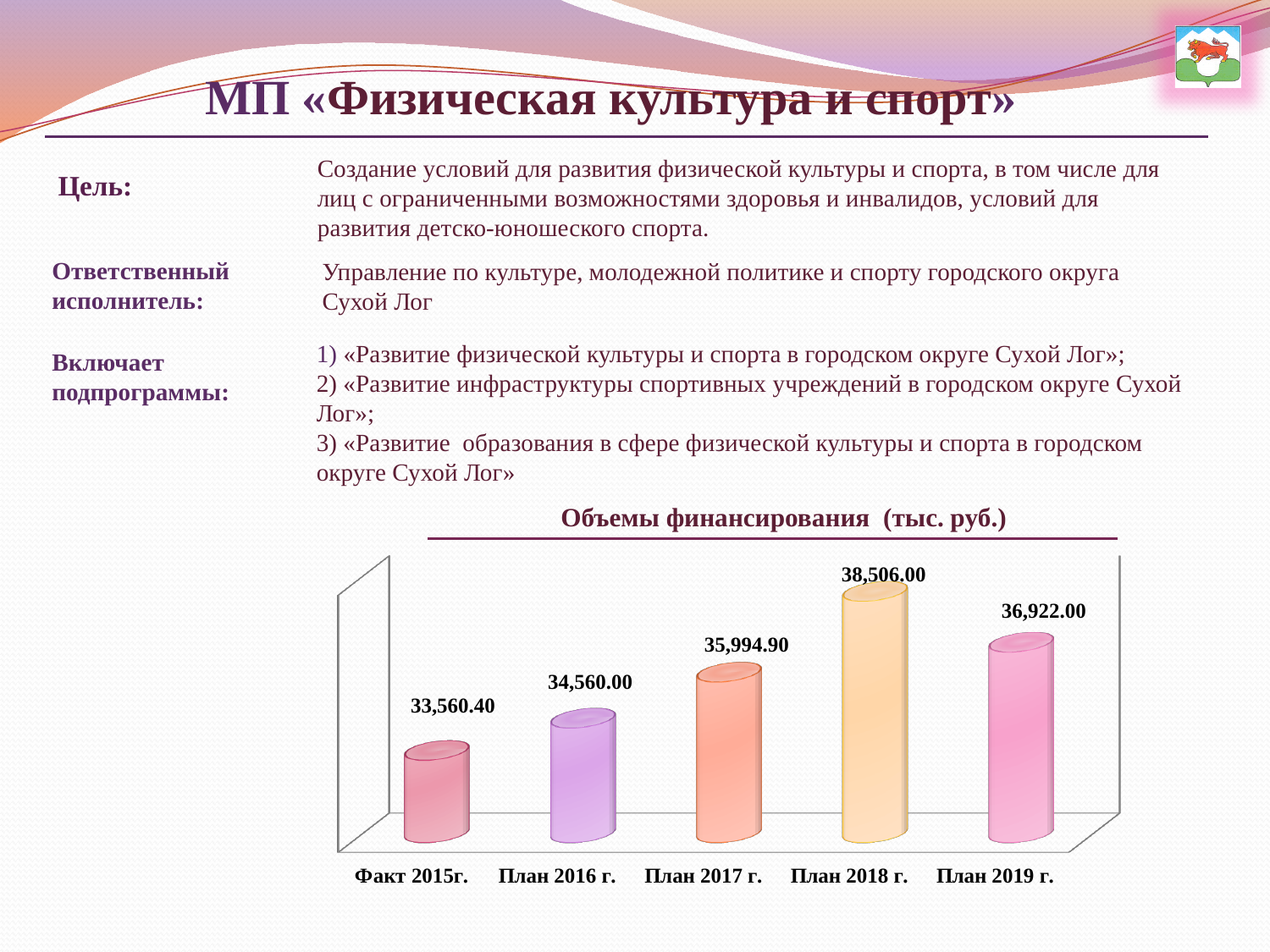
What is the value for План 2019 г. in the chart «Объемы финансирования (тыс. руб.)»? 36,922.00 Do the values in the chart «Объемы финансирования (тыс. руб.)» rise or fall from Факт 2015г. to План 2018 г.? Rise Which category has the lowest value in the chart «Объемы финансирования (тыс. руб.)»? Факт 2015г. How many categories are shown in the chart «Объемы финансирования (тыс. руб.)»? 5 Which category has the highest value in the chart «Объемы финансирования (тыс. руб.)»? План 2018 г. Which is larger in the chart «Объемы финансирования (тыс. руб.)»: the value for План 2017 г. or the value for План 2019 г.? План 2019 г. What is the value for План 2017 г. in the chart «Объемы финансирования (тыс. руб.)»? 35,994.90 What kind of chart is «Объемы финансирования (тыс. руб.)»? Bar chart What is the title of the chart on the slide? Объемы финансирования (тыс. руб.) What is the value for Факт 2015г. in the chart «Объемы финансирования (тыс. руб.)»? 33,560.40 What is the difference between the values for План 2018 г. and План 2019 г. in the chart «Объемы финансирования (тыс. руб.)»? 1,584.00 What is the difference between the values for План 2016 г. and Факт 2015г. in the chart «Объемы финансирования (тыс. руб.)»? 999.60